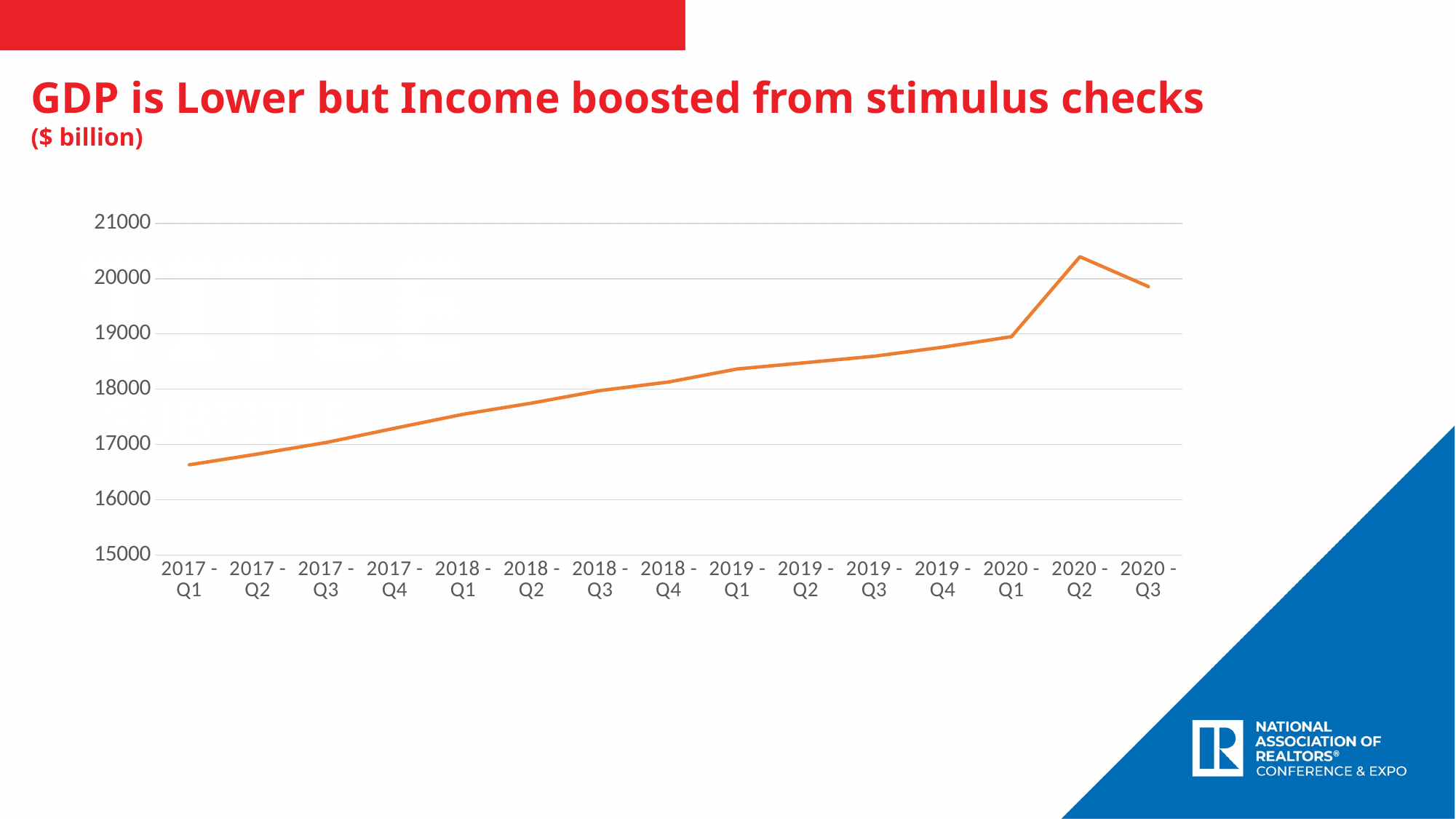
Which quarter has the highest value on the chart? 2020 - Q2 Do the values rise or fall from 2017 - Q1 to 2020 - Q1? rise What unit is stated under the chart title? $ billion Which quarter has the lowest value on the chart? 2017 - Q1 Which is larger, the value for 2020 - Q2 or the value for 2020 - Q3? 2020 - Q2 Is the value for 2017 - Q1 greater or less than 17000? less What kind of chart is shown on the slide? line chart How many quarters are plotted along the x axis? 15 Is the value for 2020 - Q3 greater or less than 19000? greater Is the value for 2020 - Q2 greater or less than 20000? greater What is the title of the chart on the slide? GDP is Lower but Income boosted from stimulus checks